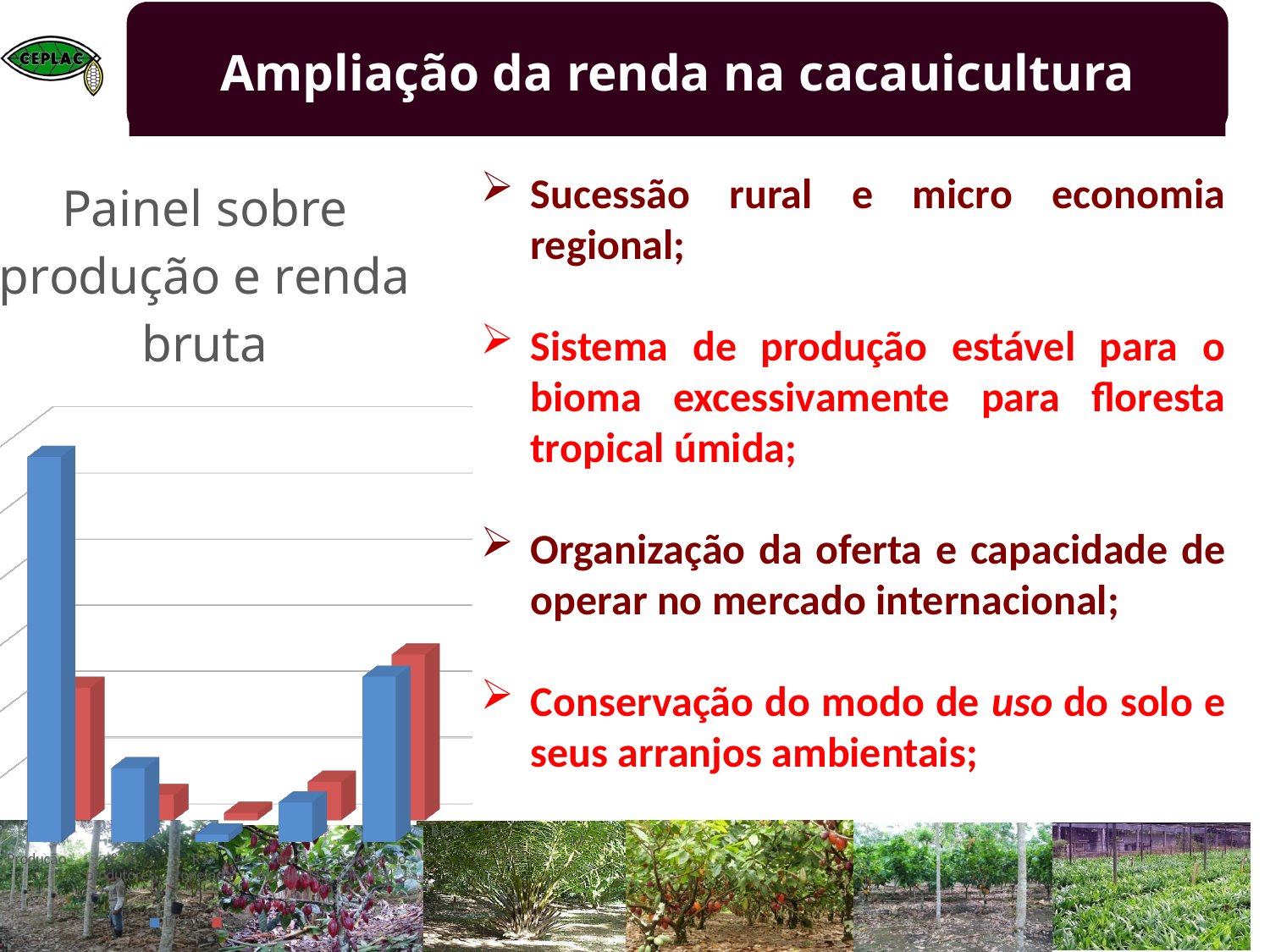
What is the title of the chart on the slide? Painel sobre produção e renda bruta Do the blue bars rise or fall from the first group to the third group? fall Do the blue bars rise or fall from the third group to the fourth group? rise What kind of chart is shown on the slide? bar chart In the first (leftmost) group, which bar is taller, the blue one or the red one? the blue one Which bar is the tallest in the chart? the blue bar in the first (leftmost) group How many groups of bars are plotted in the chart? 5 What two colours are used for the bars in the chart? blue and red Which group has the tallest red bar? the fifth (rightmost) group How many data series (bar colours) are plotted in the chart? 2